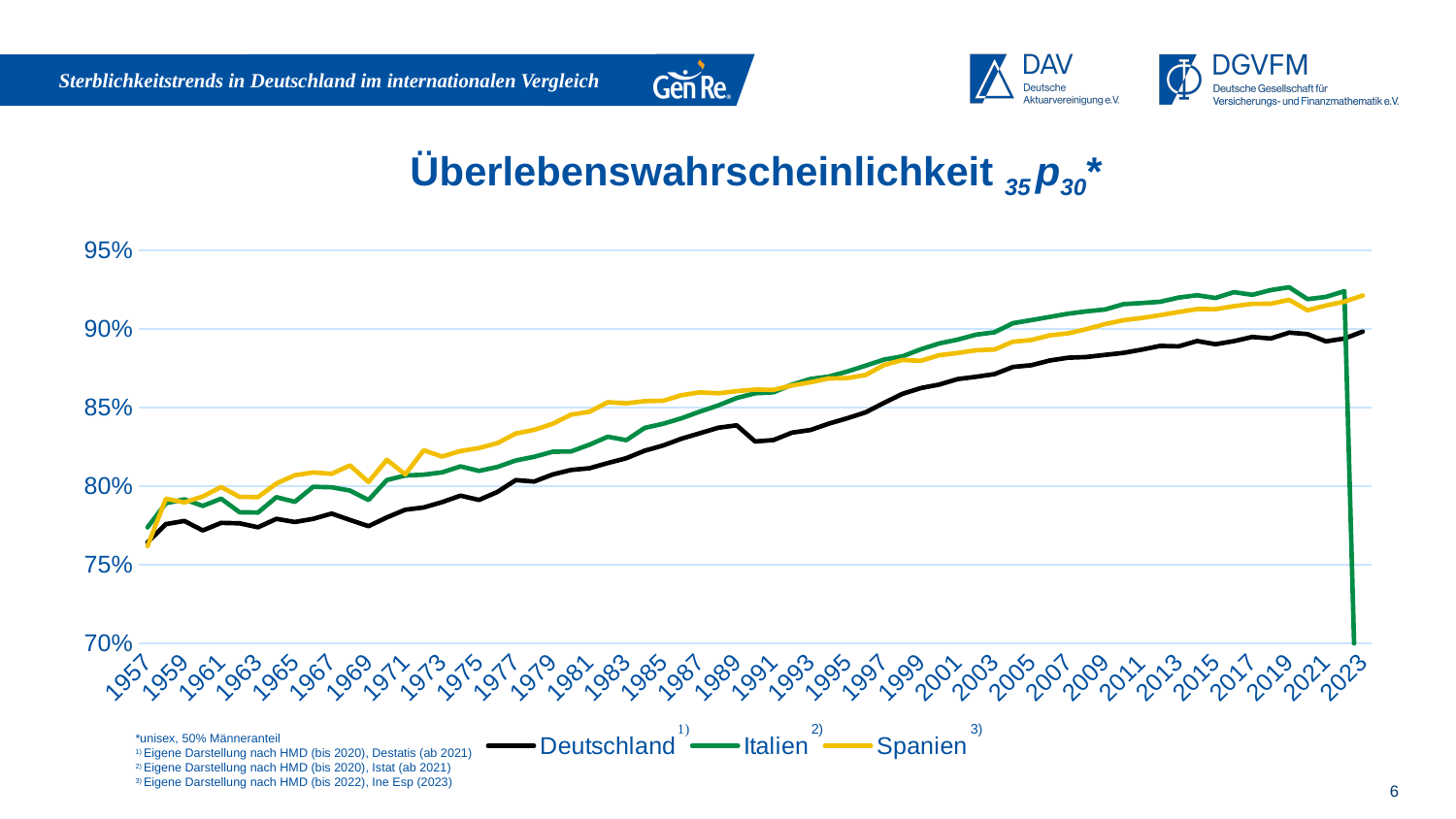
Is the value for Deutschland in 1957 greater or less than 80%? less How many series does the legend list? 3 Is the value for Italien in 2019 greater or less than 90%? greater What colour is the line for Deutschland? black Which countries are listed in the chart legend? Deutschland, Italien, Spanien Which series has the lowest value in 2001? Deutschland Is the value for Deutschland in 2023 greater or less than 85%? greater Does the value for Deutschland rise or fall from 1957 to 2021? rise In 1975, which is higher: Spanien or Deutschland? Spanien What kind of chart is shown on the slide? line chart In 2010, which is higher: Italien or Deutschland? Italien